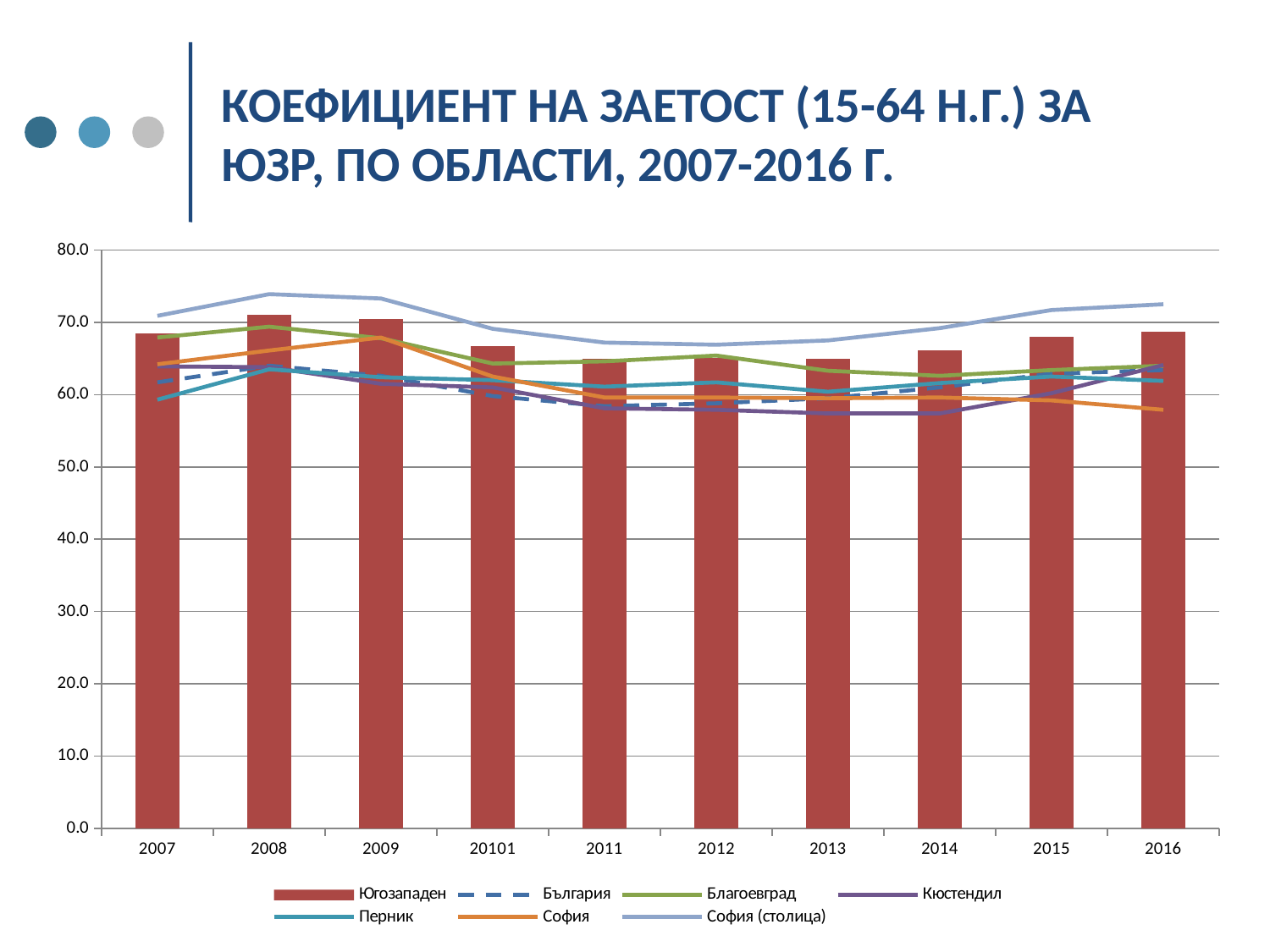
Is the value for Кюстендил in 2013 greater or less than 60? less What kind of chart is shown on the slide? A combined bar and line chart Is the Югозападен bar for 2011 greater or less than 70? less Is the value for София in 2016 greater or less than 60? less In 2012, which is larger: София (столица) or Кюстендил? София (столица) Which series is drawn with a dashed line? България How many years are shown along the x axis? 10 Which series has the highest values across all years? София (столица) How many series does the legend list? 7 Which series is plotted as bars rather than a line? Югозападен